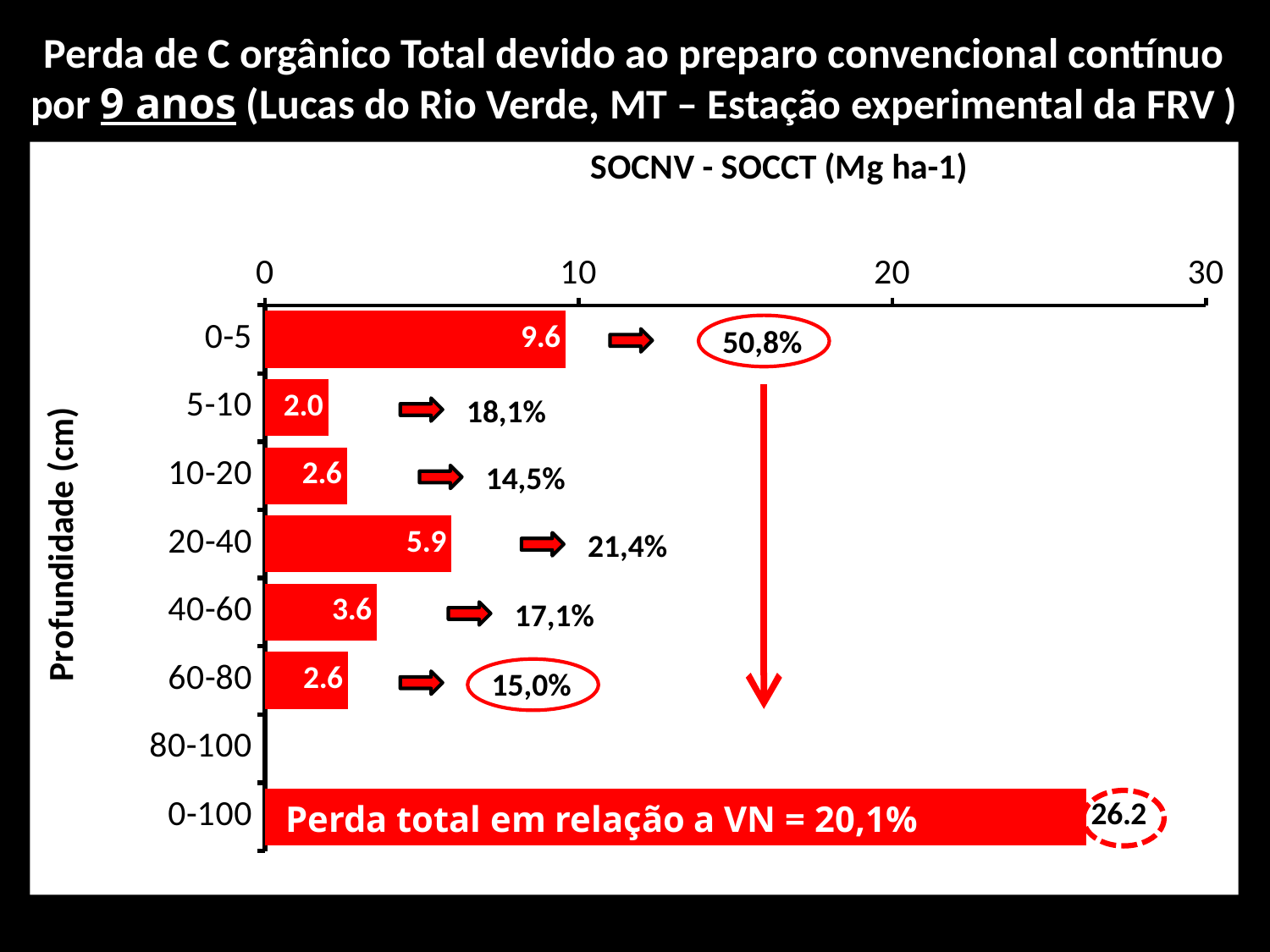
Which depth category has the highest plotted value? 0-100 What is the difference between the values for 0-5 cm and 5-10 cm? 7.6 Which is larger, the value for 20-40 cm or the value for 40-60 cm? 20-40 What is the value for the 0-100 cm depth? 26.2 What is the value for the 0-5 cm depth? 9.6 What is the title of the horizontal axis of the chart? SOCNV - SOCCT (Mg ha-1) What percentage is shown next to the 0-5 cm bar? 50,8% What is the value for the 40-60 cm depth? 3.6 What kind of chart is shown on the slide? bar chart Is the value for 0-100 cm greater or less than 20? greater What is the value for the 20-40 cm depth? 5.9